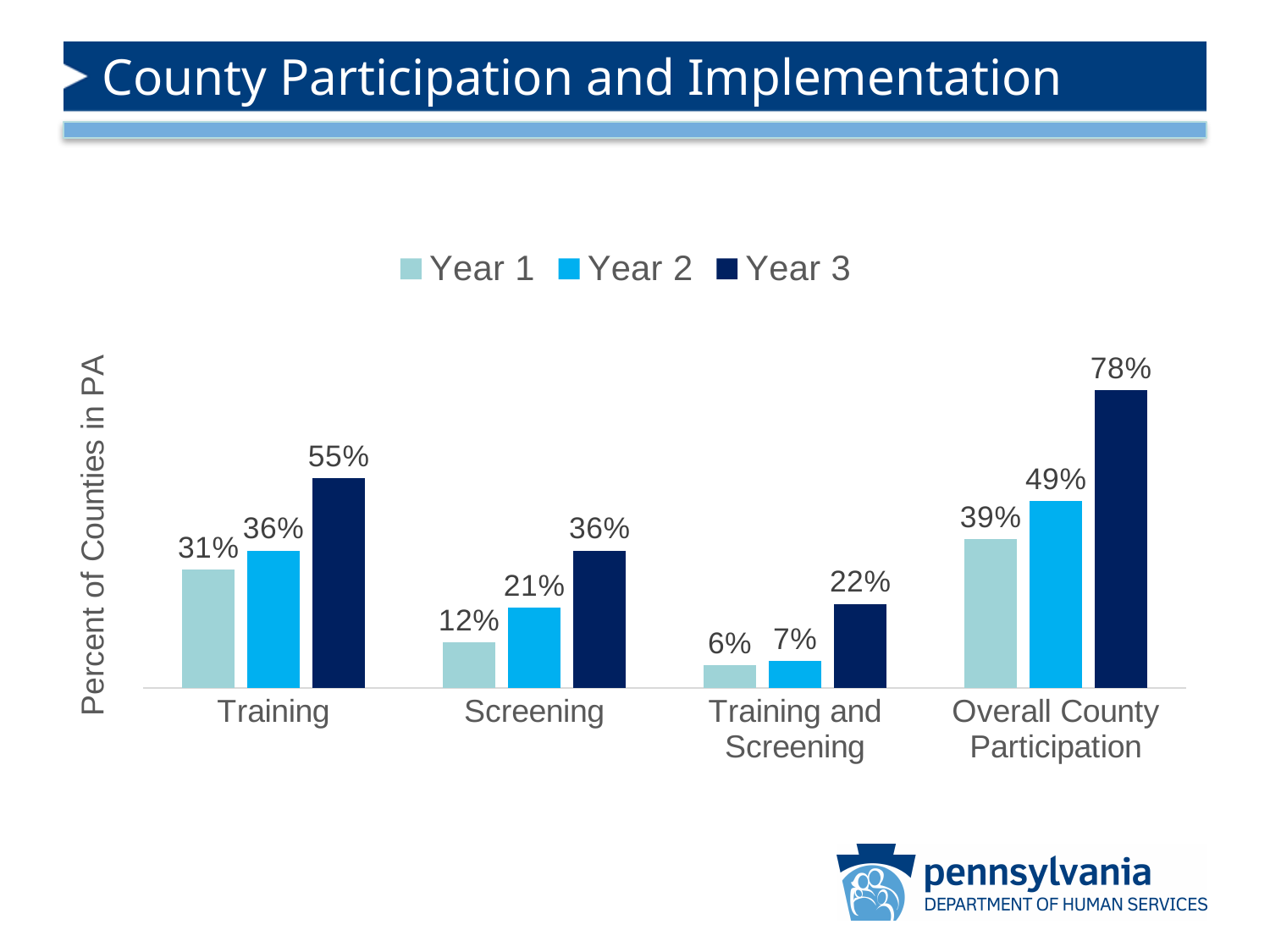
What is the Year 1 value for Screening? 12% What kind of chart is shown on the slide? Bar chart Which is larger: the Year 2 value for Training or the Year 3 value for Screening? They are equal (36%) Which category has the lowest Year 1 value? Training and Screening What is the Year 3 value for Training? 55% How many series does the legend list? 3 Which is larger: the Year 3 value for Training and Screening or the Year 2 value for Screening? Year 3 value for Training and Screening Which category has the highest Year 3 value? Overall County Participation What is the difference between the Year 3 and Year 1 values for Overall County Participation? 39% How many categories are shown on the x axis? 4 What is the Year 2 value for Overall County Participation? 49% What is the difference between the Year 2 and Year 1 values for Screening? 9%